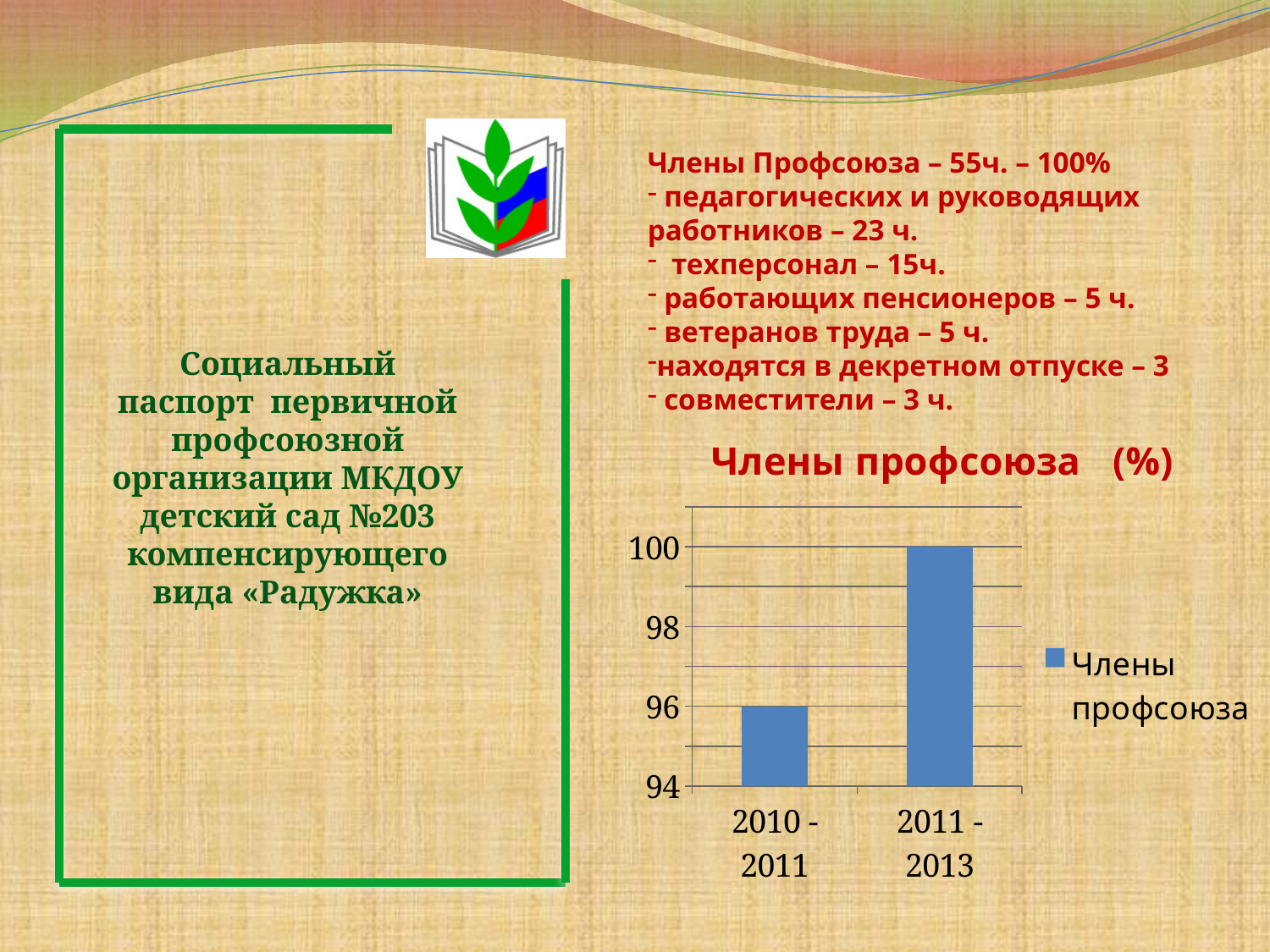
Which period has the lowest value in the "Члены профсоюза (%)" chart? 2010 - 2011 How many categories are shown on the x axis of the "Члены профсоюза (%)" chart? 2 Which period has the highest value in the "Члены профсоюза (%)" chart? 2011 - 2013 How many series does the legend of the "Члены профсоюза (%)" chart list? 1 What is the difference between the values for 2011 - 2013 and 2010 - 2011 in the "Члены профсоюза (%)" chart? 4 Do the values rise or fall from 2010 - 2011 to 2011 - 2013 in the "Члены профсоюза (%)" chart? rise What is the value for 2010 - 2011 in the "Члены профсоюза (%)" chart? 96 What is the legend entry in the "Члены профсоюза (%)" chart? Члены профсоюза Which is larger in the "Члены профсоюза (%)" chart: the value for 2010 - 2011 or for 2011 - 2013? 2011 - 2013 What type of chart is shown under the title "Члены профсоюза (%)"? bar chart Is the value for 2010 - 2011 in the "Члены профсоюза (%)" chart greater or less than 98? less What is the value for 2011 - 2013 in the "Члены профсоюза (%)" chart? 100